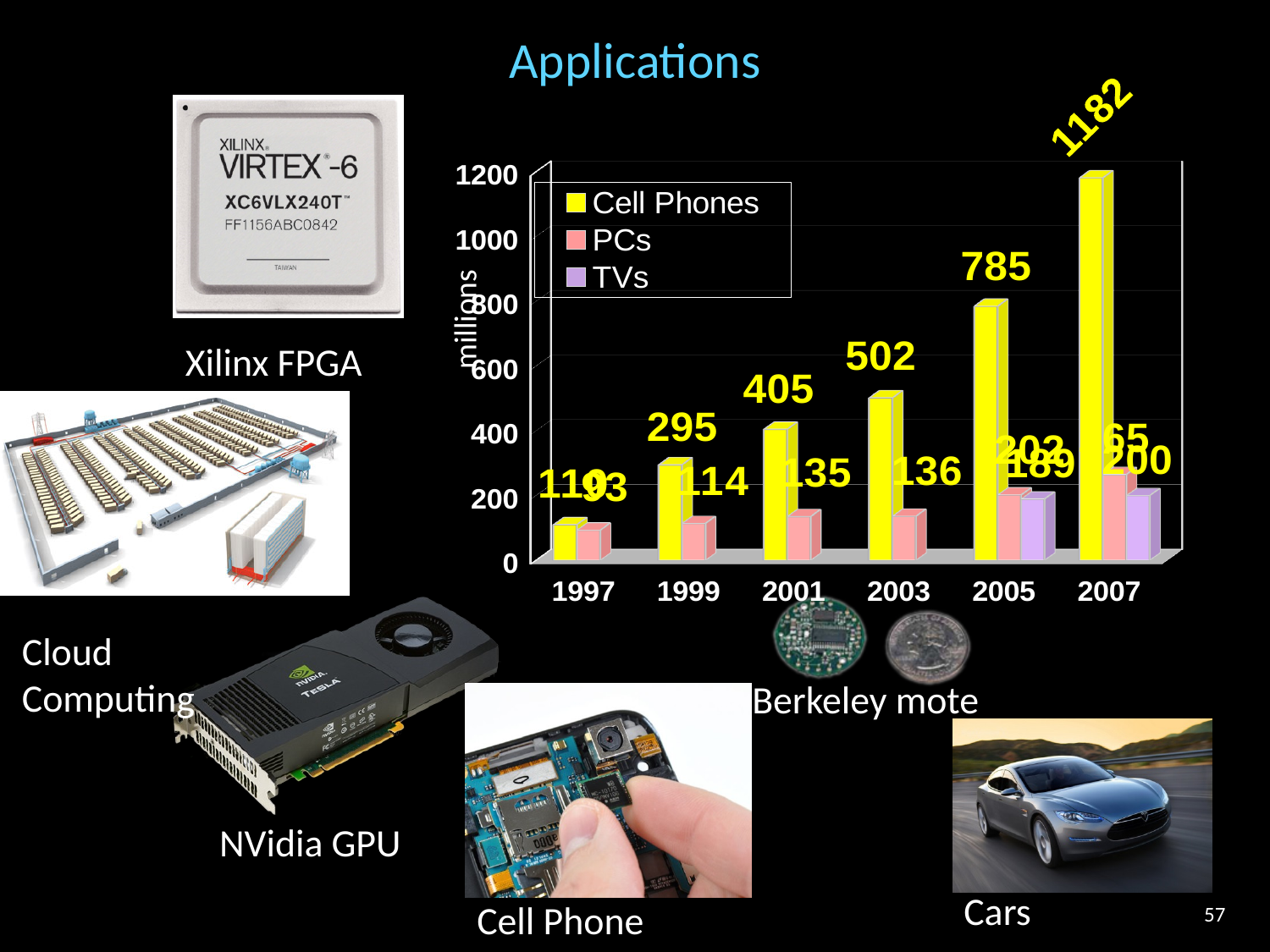
What is the value for Cell Phones in 2005? 785 What is the difference between the Cell Phones values for 2007 and 2005? 397 What kind of chart is shown on the slide? bar chart How many series does the legend list? 3 How many years are shown on the x axis? 6 Do the Cell Phones values rise or fall from 1997 to 2007? rise What is the difference between the Cell Phones values for 2003 and 2001? 97 In which year is the Cell Phones value highest? 2007 What is the value for TVs in 2005? 189 Which is larger in 2003, Cell Phones or PCs? Cell Phones What is the value for Cell Phones in 2007? 1182 What is the value for PCs in 2001? 135